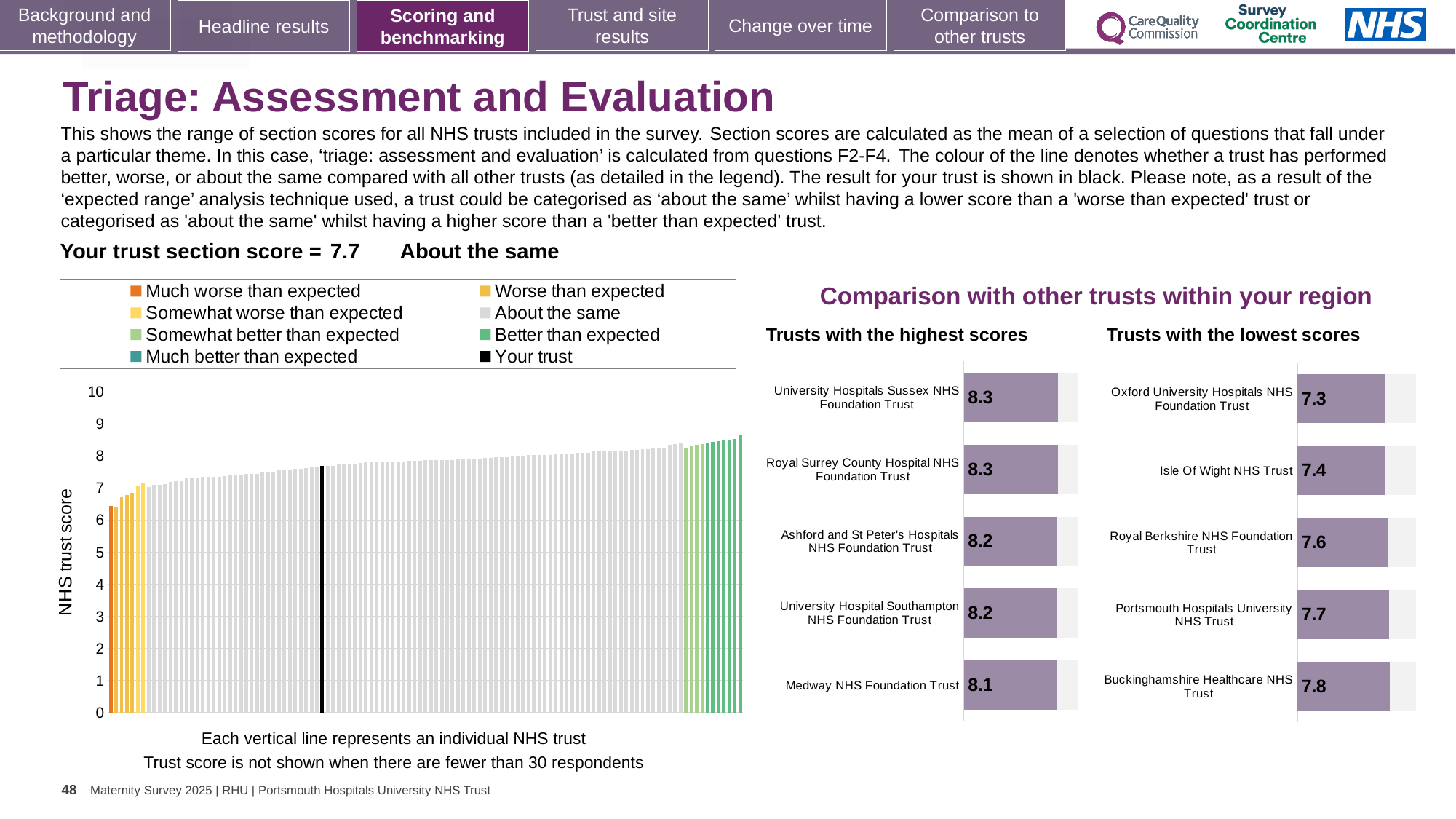
In the large chart on the left showing NHS trust scores, how many entries does the legend list? 8 In the 'Trusts with the lowest scores' chart, how many trusts are shown? 5 In the 'Trusts with the lowest scores' chart, what is the score for Oxford University Hospitals NHS Foundation Trust? 7.3 In the large chart on the left, what colour denotes 'Your trust' according to the legend? Black In the 'Trusts with the highest scores' chart, which trust has the lowest score? Medway NHS Foundation Trust In the 'Trusts with the highest scores' chart, what is the score for Medway NHS Foundation Trust? 8.1 In the 'Trusts with the lowest scores' chart, what is the difference between the scores of Buckinghamshire Healthcare NHS Trust and Oxford University Hospitals NHS Foundation Trust? 0.5 In the large chart on the left showing NHS trust scores, do the values rise or fall from left to right? Rise In the 'Trusts with the highest scores' chart, which has the larger score: University Hospitals Sussex NHS Foundation Trust or Medway NHS Foundation Trust? University Hospitals Sussex NHS Foundation Trust What kind of chart is the large chart on the left showing NHS trust scores? Bar chart In the 'Trusts with the lowest scores' chart, which trust has the highest score? Buckinghamshire Healthcare NHS Trust In the large chart on the left, is the value of the black bar representing your trust greater or less than 7? greater